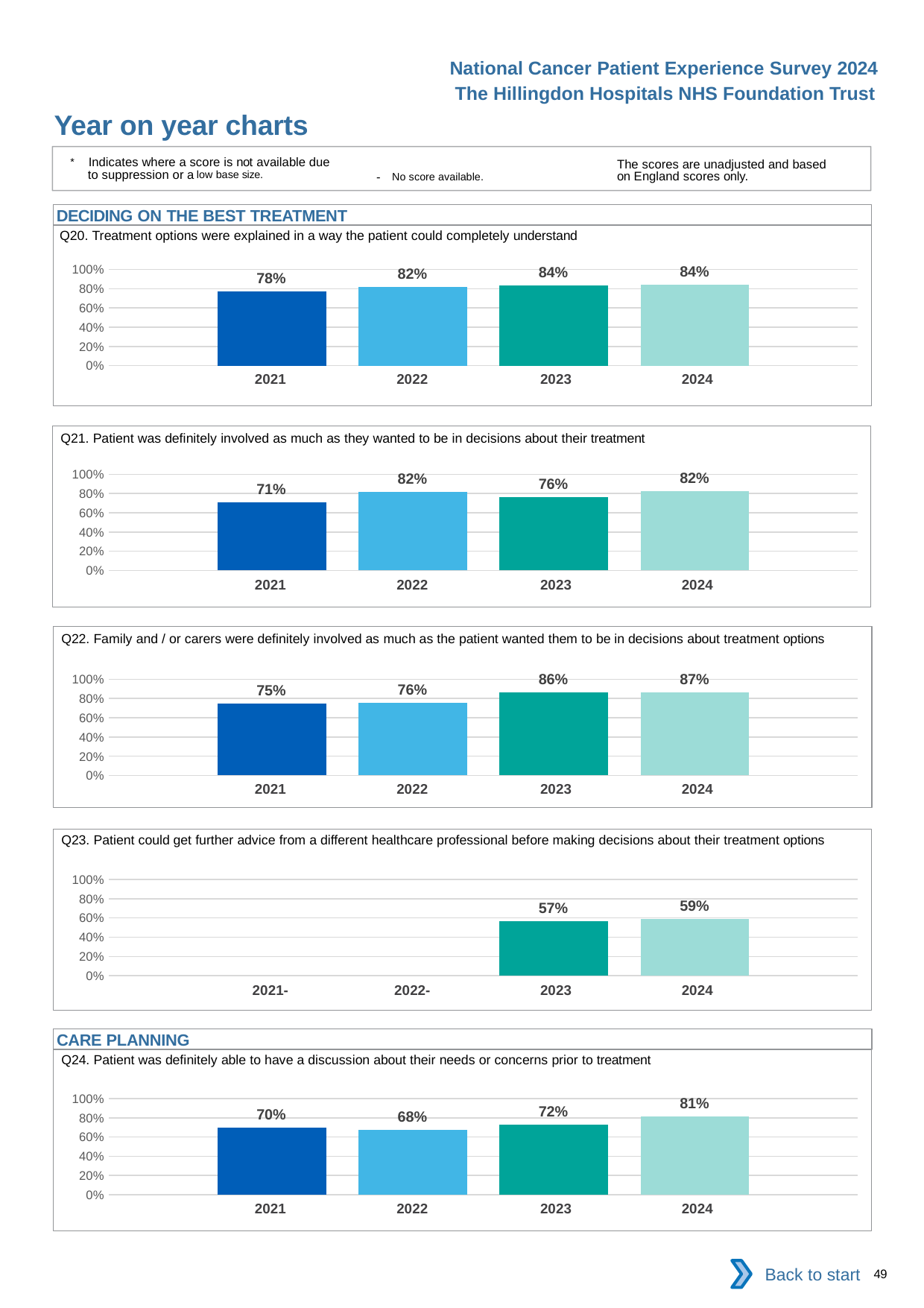
In the Q24 chart, which is larger, the value for 2021 or the value for 2022? 2021 What type of chart is used for Q22? Bar chart In the Q22 chart, do the values rise or fall from 2021 to 2024? Rise In the Q23 chart, what is the value for 2024? 59% In the Q24 chart, which year has the highest value? 2024 Which section heading appears above the Q24 chart? CARE PLANNING In the Q20 chart, how many years are shown on the x axis? 4 In the Q23 chart, how many years have a bar plotted? 2 In the Q21 chart, what is the difference between the 2022 and 2023 values? 6% In the Q20 chart, what is the value for 2021? 78% In the Q21 chart, which year has the lowest value? 2021 In the Q22 chart, what is the difference between the 2024 and 2021 values? 12%